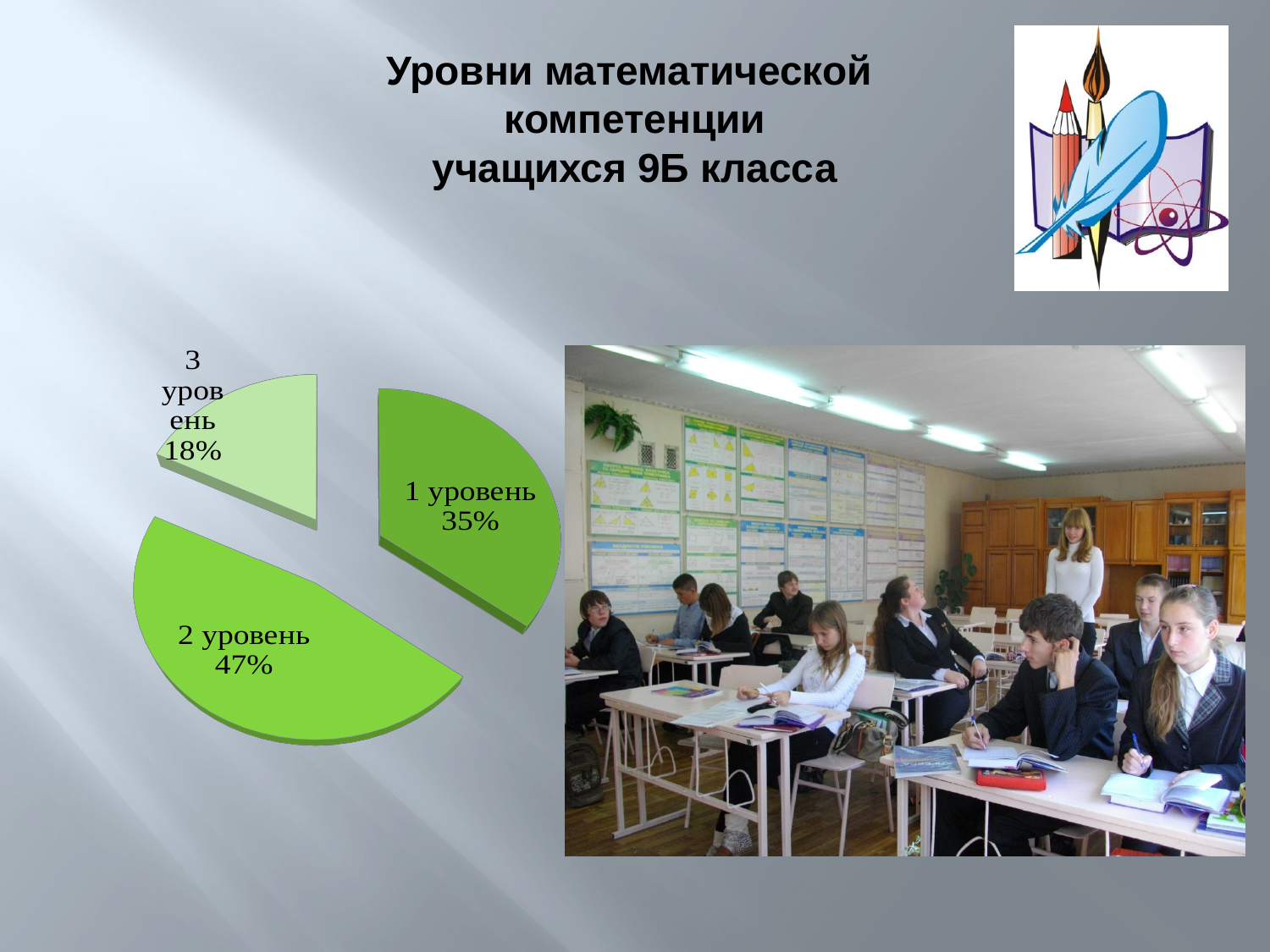
What is the difference in percentage points between "2 уровень" and "1 уровень"? 12 What share of the pie does "3 уровень" have? 18% What is the difference in percentage points between "1 уровень" and "3 уровень"? 17 Which level has the smallest share of the pie? 3 уровень What share of the pie does "1 уровень" have? 35% What type of chart is shown on the slide? pie chart What share of the pie does "2 уровень" have? 47% Which is larger, the share for "1 уровень" or the share for "3 уровень"? 1 уровень How many slices does the pie chart have? 3 Which level has the largest share of the pie? 2 уровень Which slice of the pie chart is the lightest green? 3 уровень What is the title of the slide containing the pie chart? Уровни математической компетенции учащихся 9Б класса